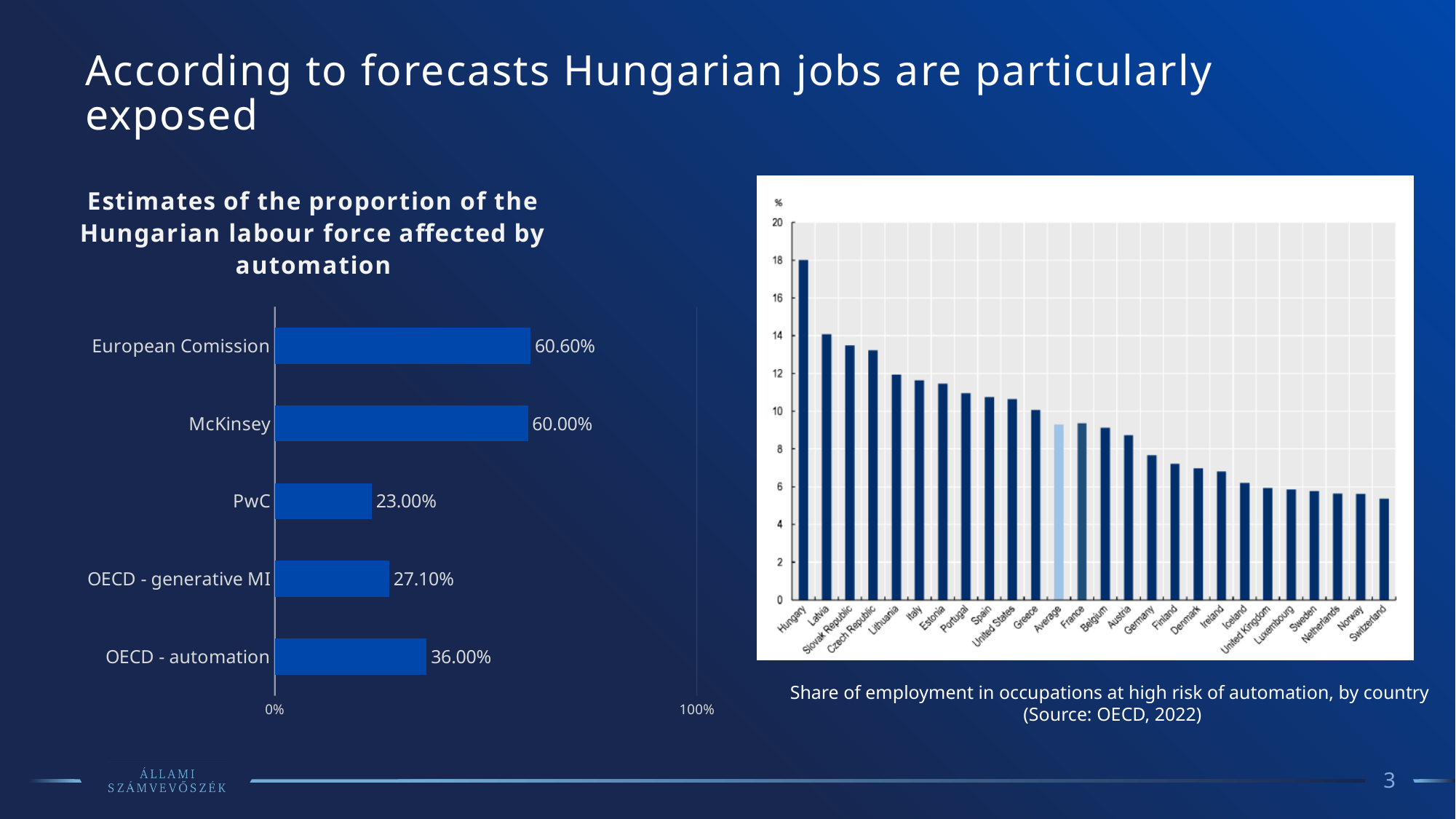
In the chart 'Estimates of the proportion of the Hungarian labour force affected by automation', what is the value for OECD - automation? 36.00% In the chart 'Share of employment in occupations at high risk of automation, by country', which country has the lowest share? Switzerland In the chart 'Share of employment in occupations at high risk of automation, by country', is the value for Hungary greater or less than 16? greater In the chart 'Estimates of the proportion of the Hungarian labour force affected by automation', what is the difference between the OECD - automation and OECD - generative MI estimates? 8.90% In the chart 'Estimates of the proportion of the Hungarian labour force affected by automation', which source gives the highest estimate? European Comission What kind of chart is the 'Estimates of the proportion of the Hungarian labour force affected by automation' chart? Bar chart In the chart 'Share of employment in occupations at high risk of automation, by country', which country has the highest share? Hungary In the chart 'Estimates of the proportion of the Hungarian labour force affected by automation', how many sources are listed? 5 In the chart 'Estimates of the proportion of the Hungarian labour force affected by automation', which source gives the lowest estimate? PwC In the chart 'Estimates of the proportion of the Hungarian labour force affected by automation', what is the value for PwC? 23.00% In the chart 'Share of employment in occupations at high risk of automation, by country', is the value for Germany greater or less than 8? less In the chart 'Estimates of the proportion of the Hungarian labour force affected by automation', what is the value for McKinsey? 60.00%